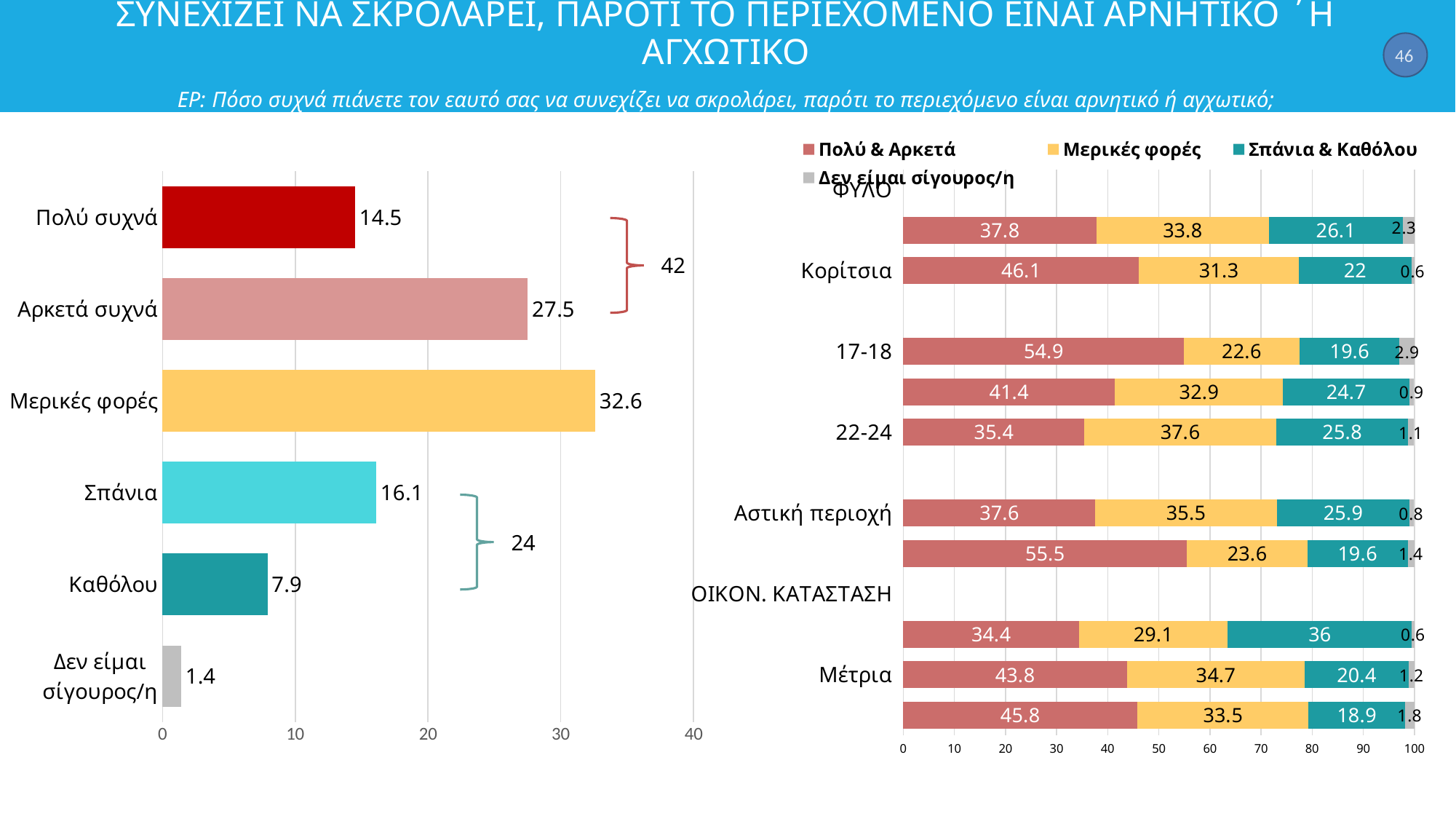
In the left chart, what is the difference between the values for Αρκετά συχνά and Πολύ συχνά? 13 What kind of chart is the left chart? Bar chart In the right chart, what is the value of Πολύ & Αρκετά for 17-18? 54.9 In the left chart, which is larger: the value for Σπάνια or the value for Πολύ συχνά? Σπάνια In the left chart, what is the value for Καθόλου? 7.9 In the right chart, how many series does the legend list? 4 In the left chart, how many categories are shown? 6 In the right chart, what is the total of the stacked bar for Μέτρια? 100.1 In the left chart, which category has the highest value? Μερικές φορές In the left chart, which category has the lowest value? Δεν είμαι σίγουρος/η In the left chart, what is the value for Μερικές φορές? 32.6 In the right chart, what is the value of Σπάνια & Καθόλου for Κορίτσια? 22